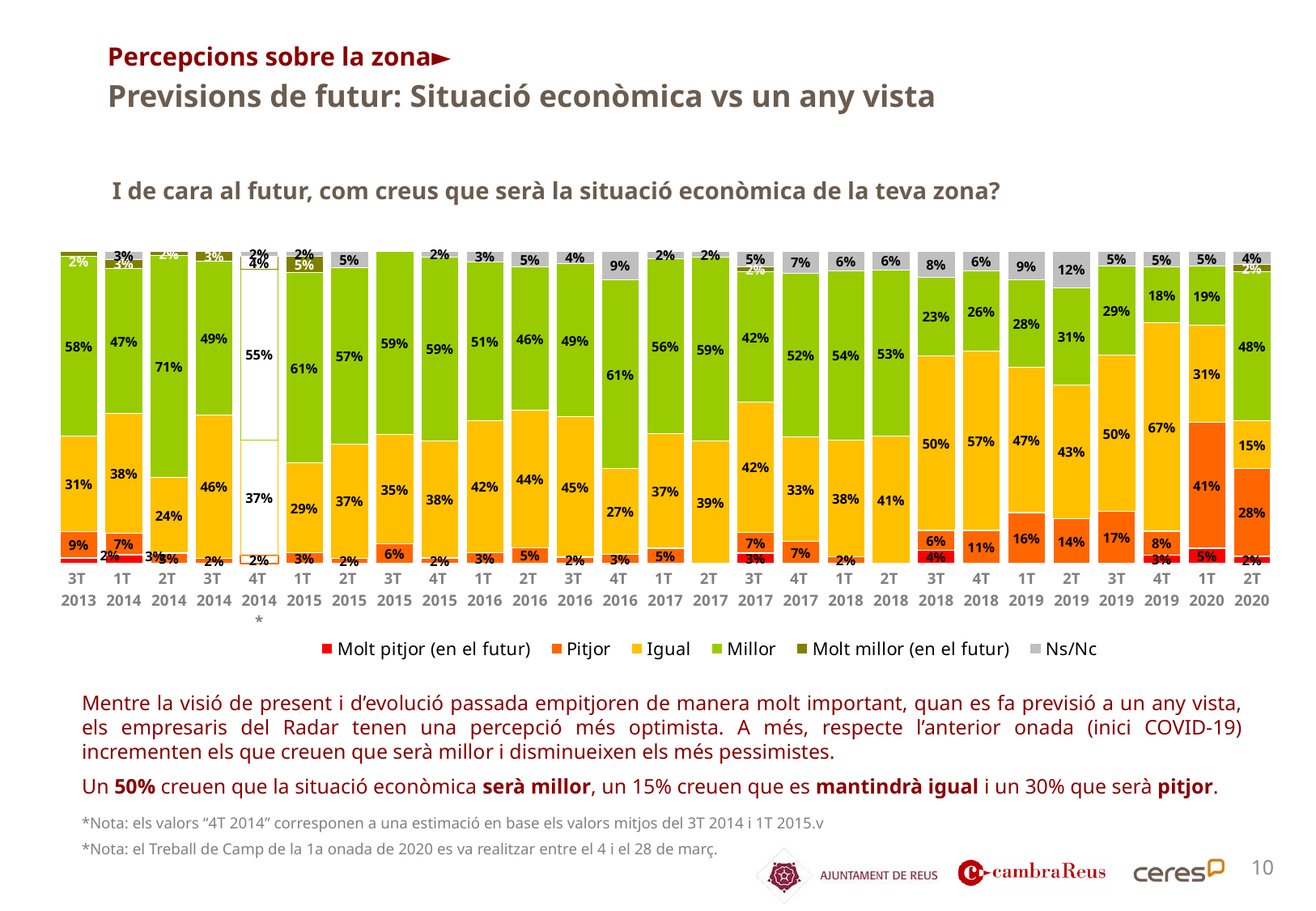
How many series does the legend list? 6 What kind of chart is shown on the slide? Stacked bar chart What is the 'Igual' value for 4T 2019? 67% Which series is shown in light green in the legend? Millor What is the 'Pitjor' value for 1T 2020? 41% How many quarters (bars) are plotted on the chart? 27 What is the 'Millor' value for 2T 2020? 48% Which is larger in 2T 2020: the 'Pitjor' share or the 'Igual' share? Pitjor What is the 'Ns/Nc' value for 2T 2019? 12% In which quarter is the 'Millor' share highest? 2T 2014 In which quarter is the 'Pitjor' share highest? 1T 2020 By how many percentage points did the 'Millor' share change from 1T 2020 to 2T 2020? 29 percentage points